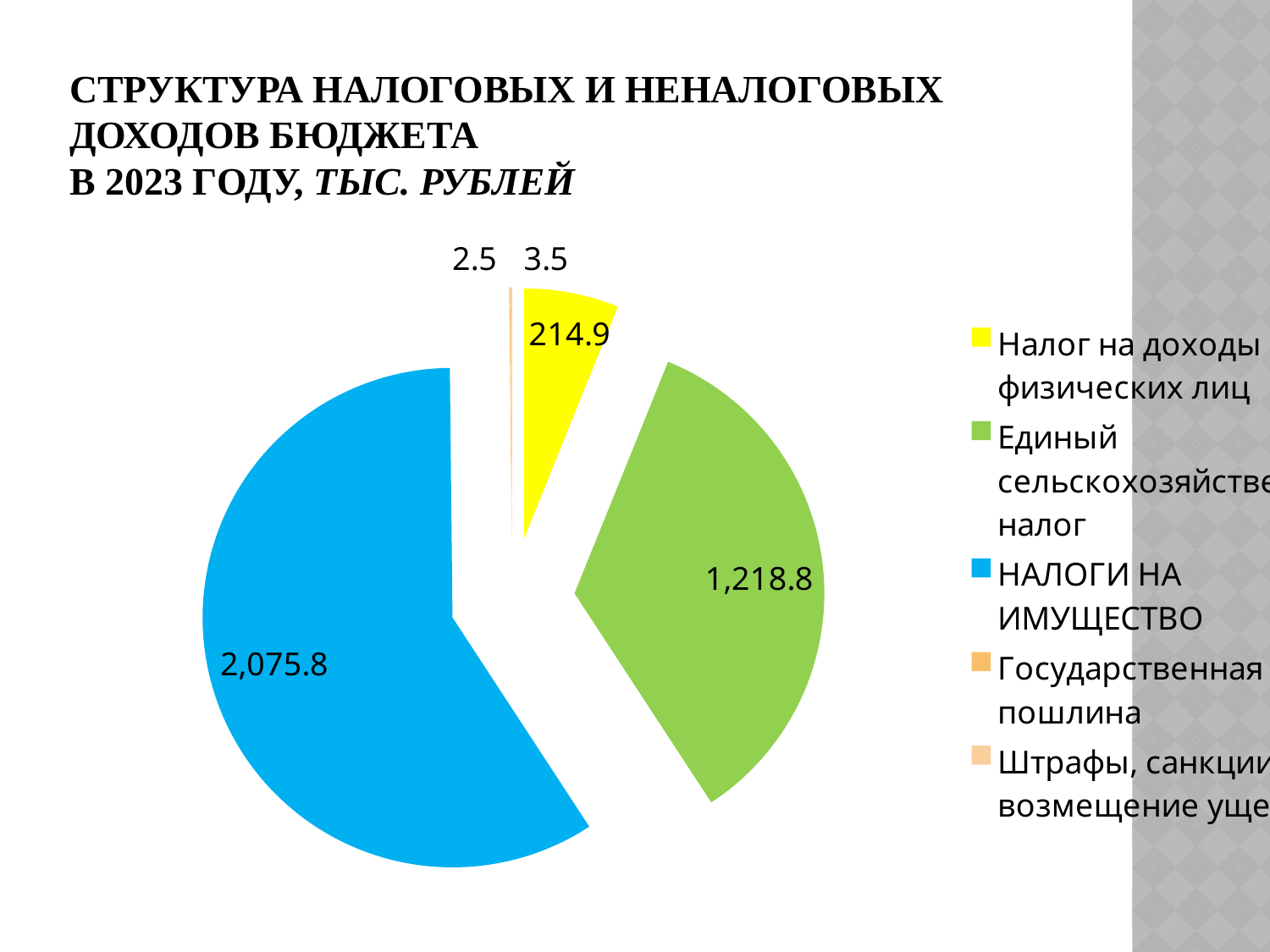
Which is larger, Единый сельскохозяйственный налог or Налог на доходы физических лиц? Единый сельскохозяйственный налог What is the value for Налог на доходы физических лиц? 214.9 Which category has the largest slice of the pie? НАЛОГИ НА ИМУЩЕСТВО What kind of chart is shown on the slide? pie chart What is the difference between НАЛОГИ НА ИМУЩЕСТВО and Единый сельскохозяйственный налог? 857.0 What is the value for Единый сельскохозяйственный налог? 1,218.8 What colour is the slice for НАЛОГИ НА ИМУЩЕСТВО? blue How many categories does the legend list? 5 In what units are the values in the chart title given? тыс. рублей How many slices does the pie chart have? 5 What is the value for НАЛОГИ НА ИМУЩЕСТВО? 2,075.8 What is the difference between Единый сельскохозяйственный налог and Налог на доходы физических лиц? 1,003.9